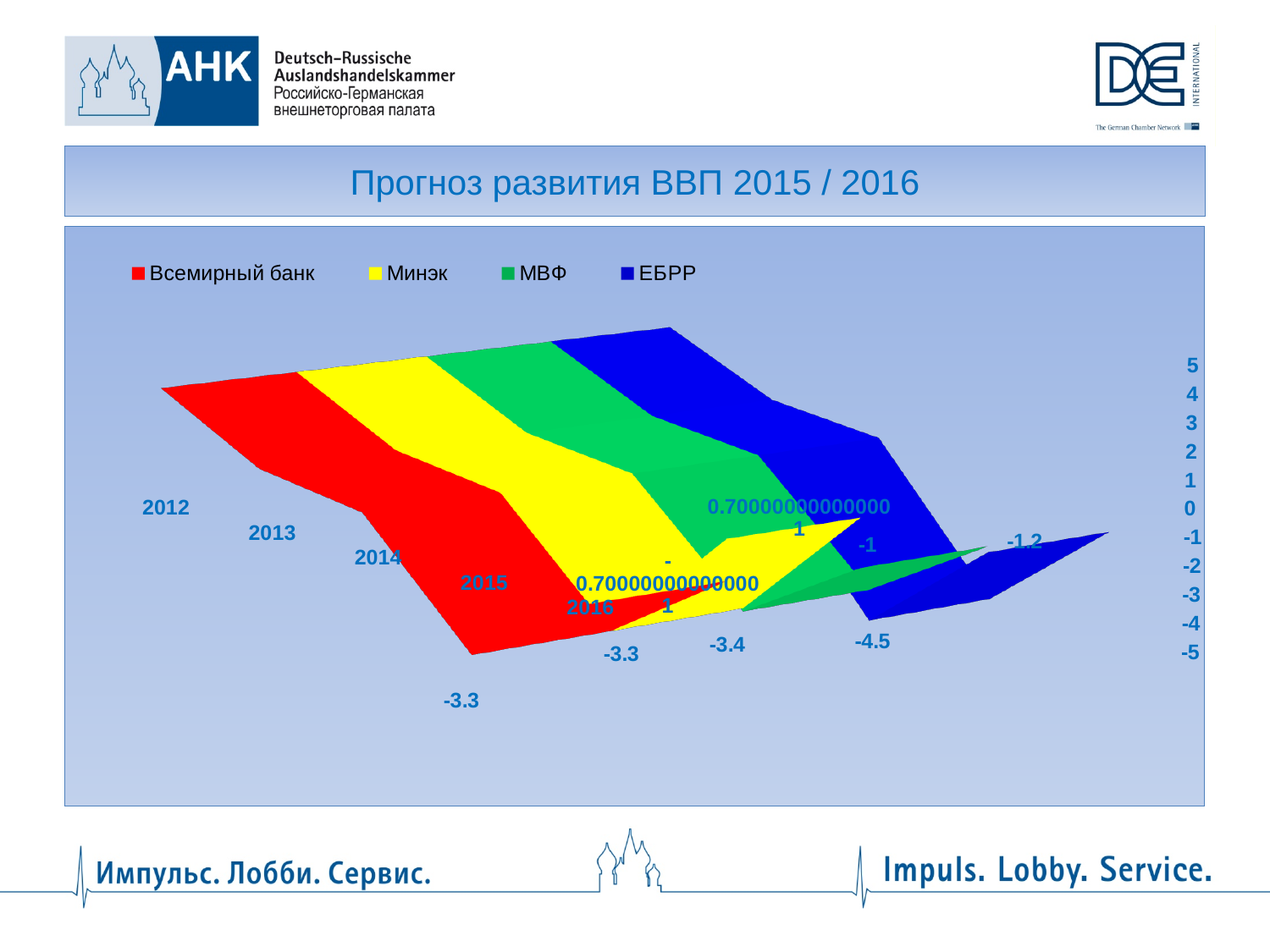
Do the values for Всемирный банк rise or fall from 2012 to 2015? fall Which colour represents ЕБРР in the chart? blue What is the value for ЕБРР in 2015? -4.5 What kind of chart is shown on the slide? 3D line chart How many series does the legend list? 4 Which series has the lowest value in 2015? ЕБРР Which is larger in 2015, the value for МВФ or the value for ЕБРР? МВФ What is the value for МВФ in 2015? -3.4 What is the difference between the 2015 values for МВФ and ЕБРР? 1.1 How many years are shown along the x axis? 5 What is the title of the chart? Прогноз развития ВВП 2015 / 2016 Is the value for ЕБРР in 2015 greater or less than -4? less